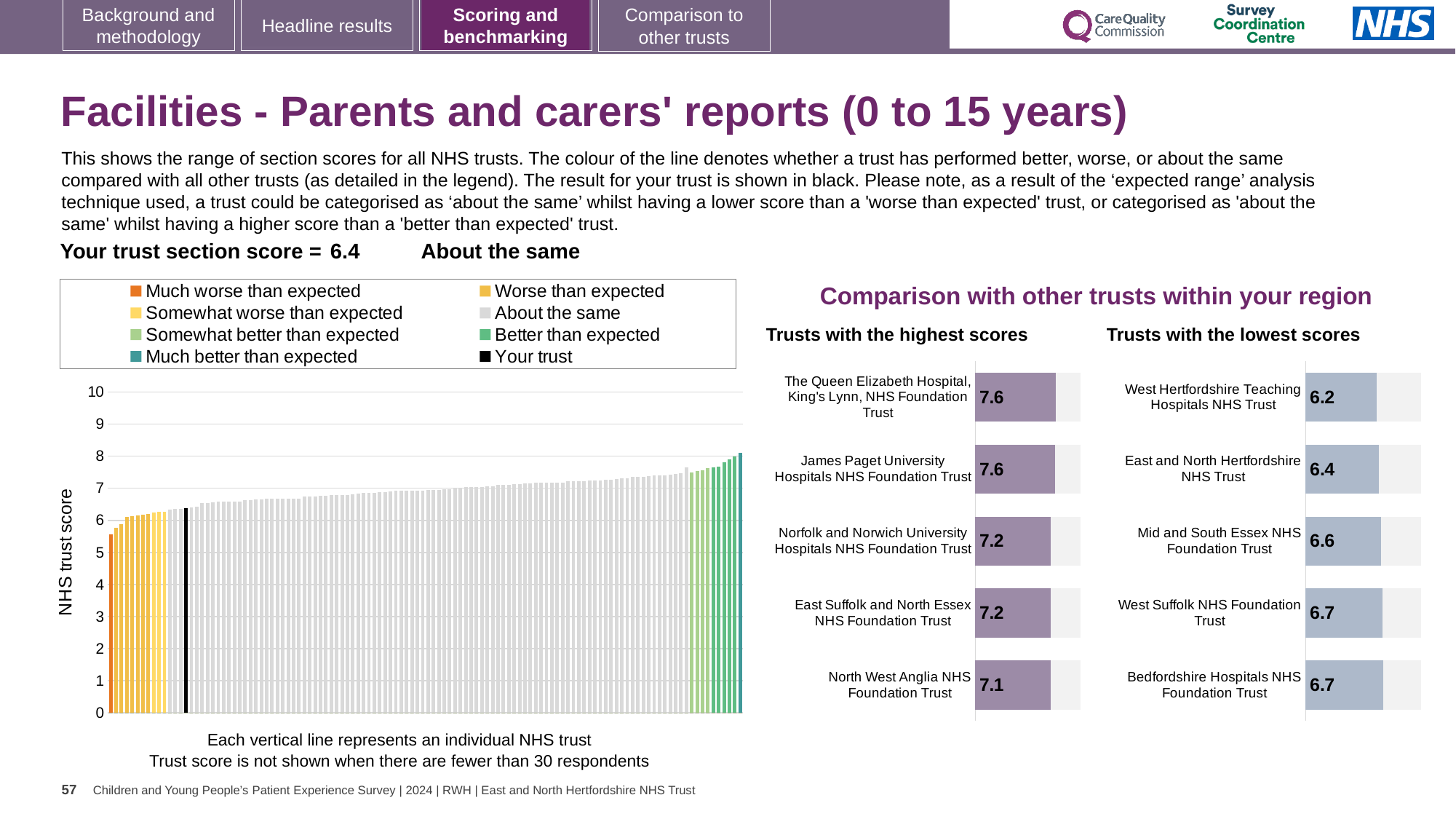
In the main chart on the left showing all NHS trusts, is the value for the lowest (leftmost) bar greater or less than 6? less In the 'Trusts with the lowest scores' chart, what is the score for West Hertfordshire Teaching Hospitals NHS Trust? 6.2 How many trusts are shown in the 'Trusts with the highest scores' chart? 5 How many entries does the legend of the main chart on the left list? 8 In the 'Trusts with the highest scores' chart, what is the score for North West Anglia NHS Foundation Trust? 7.1 In the 'Trusts with the lowest scores' chart, which has the larger score: East and North Hertfordshire NHS Trust or West Suffolk NHS Foundation Trust? West Suffolk NHS Foundation Trust In the 'Trusts with the lowest scores' chart, which trust has the lowest score? West Hertfordshire Teaching Hospitals NHS Trust In the 'Trusts with the highest scores' chart, what is the score for The Queen Elizabeth Hospital, King's Lynn, NHS Foundation Trust? 7.6 In the main chart on the left showing all NHS trusts, do the trust scores rise or fall from left to right? rise In the 'Trusts with the highest scores' chart, what is the difference between the score for James Paget University Hospitals NHS Foundation Trust and the score for North West Anglia NHS Foundation Trust? 0.5 In the 'Trusts with the lowest scores' chart, what is the difference between the score for Bedfordshire Hospitals NHS Foundation Trust and the score for West Hertfordshire Teaching Hospitals NHS Trust? 0.5 In the 'Trusts with the lowest scores' chart, what is the score for Mid and South Essex NHS Foundation Trust? 6.6